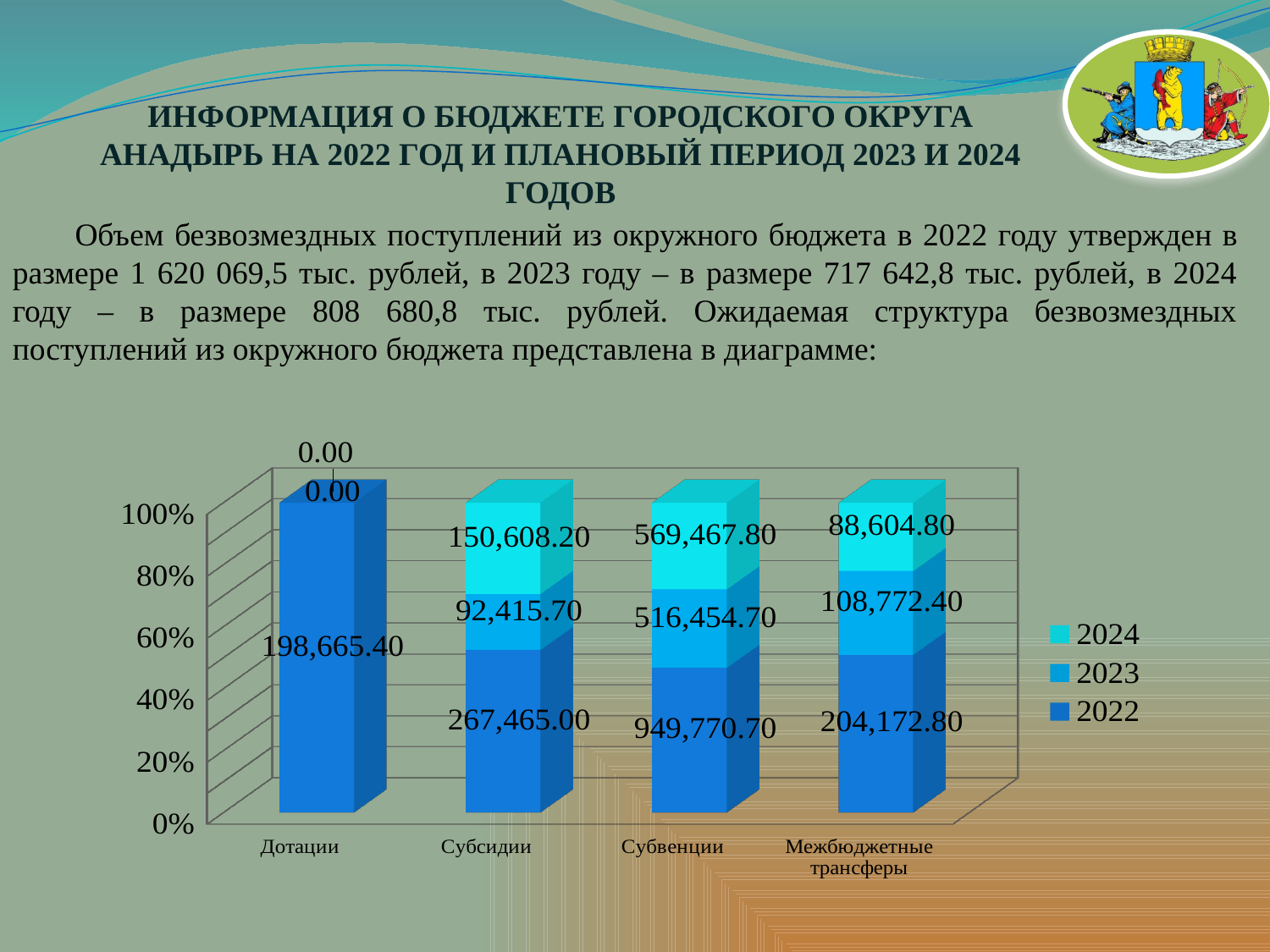
What is the 2023 value for Дотации? 0.00 How many categories are shown on the x axis? 4 What is the 2024 value for Субсидии? 150,608.20 What is the 2023 value for Межбюджетные трансферы? 108,772.40 Which category has the highest 2022 value? Субвенции What is the difference between the 2023 and 2024 values for Межбюджетные трансферы? 20,167.60 How many series does the legend list? 3 Which is larger for Субвенции: the 2023 value or the 2024 value? 2024 What is the difference between the 2024 and 2023 values for Субсидии? 58,192.50 Which category has the lowest 2022 value? Дотации What is the 2022 value for Субвенции? 949,770.70 What is the total of the three values in the Субсидии bar? 510,488.90